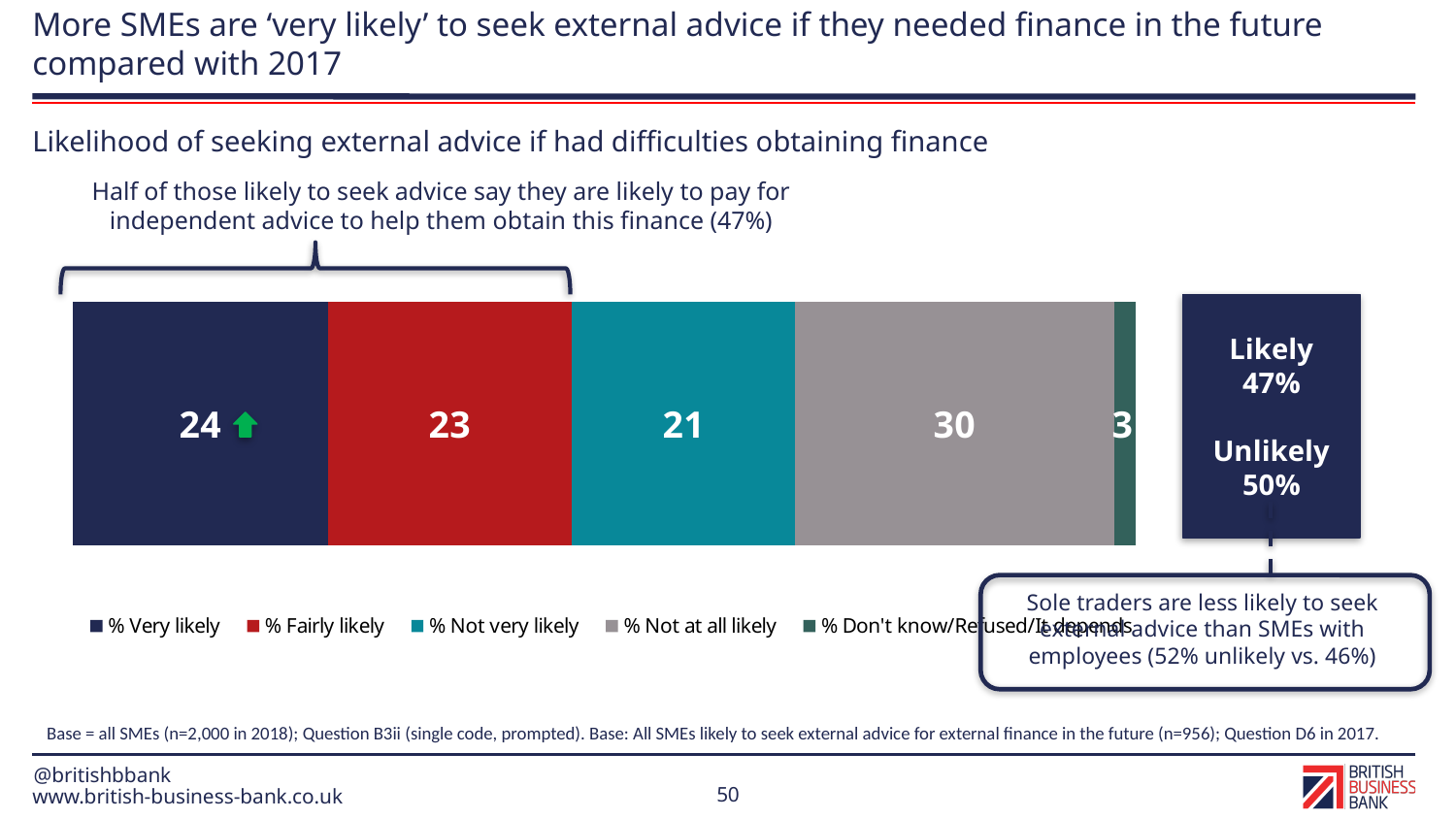
Which segment of the stacked bar has the lowest value? % Don't know/Refused/It depends How many series does the legend list? 5 What kind of chart is shown on the slide? Stacked bar chart What is the value for '% Very likely' in the stacked bar? 24 Which segment of the stacked bar has the highest value? % Not at all likely What is the value for '% Not at all likely' in the stacked bar? 30 What is the value for '% Not very likely' in the stacked bar? 21 Which is larger, the '% Fairly likely' value or the '% Not very likely' value? % Fairly likely What colour is the '% Fairly likely' segment of the bar? Red What is the combined value of the '% Very likely' and '% Fairly likely' segments? 47 What is the value for '% Fairly likely' in the stacked bar? 23 What is the difference between the '% Not at all likely' value and the '% Very likely' value? 6